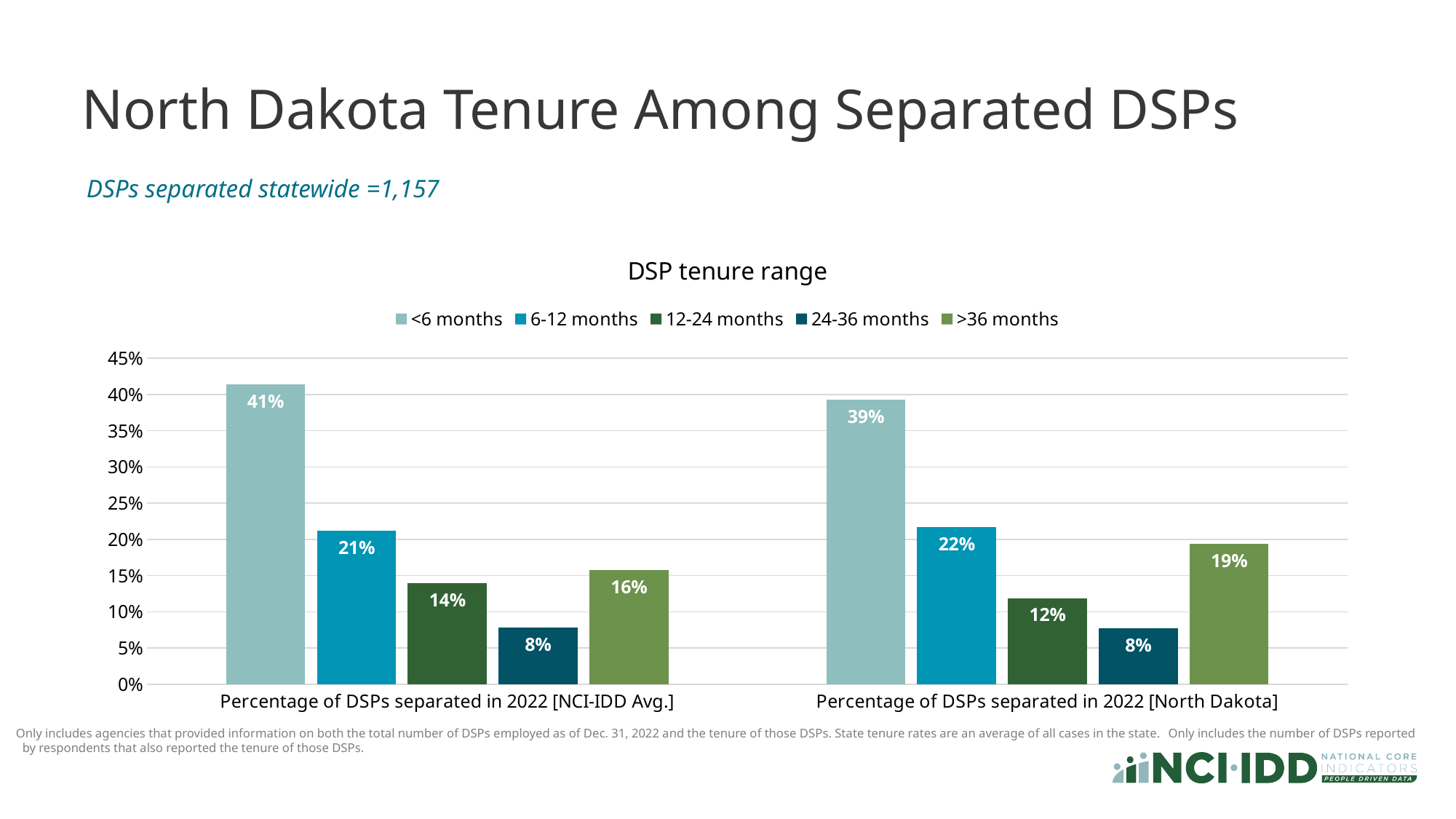
What is the value for >36 months in the North Dakota group? 19% Which tenure range has the lowest value in the NCI-IDD Avg. group? 24-36 months Which tenure range has the highest value in the North Dakota group? <6 months What kind of chart is shown on the slide? Bar chart What is the value for 12-24 months in the North Dakota group? 12% What is the title of the chart? DSP tenure range Which is larger: the >36 months value for NCI-IDD Avg. or for North Dakota? North Dakota Is the value for 6-12 months in the North Dakota group greater or less than 20%? greater How many category groups are shown on the x axis? 2 How many series does the legend list? 5 What is the difference between the <6 months values for NCI-IDD Avg. and North Dakota? 2% What is the value for <6 months in the NCI-IDD Avg. group? 41%